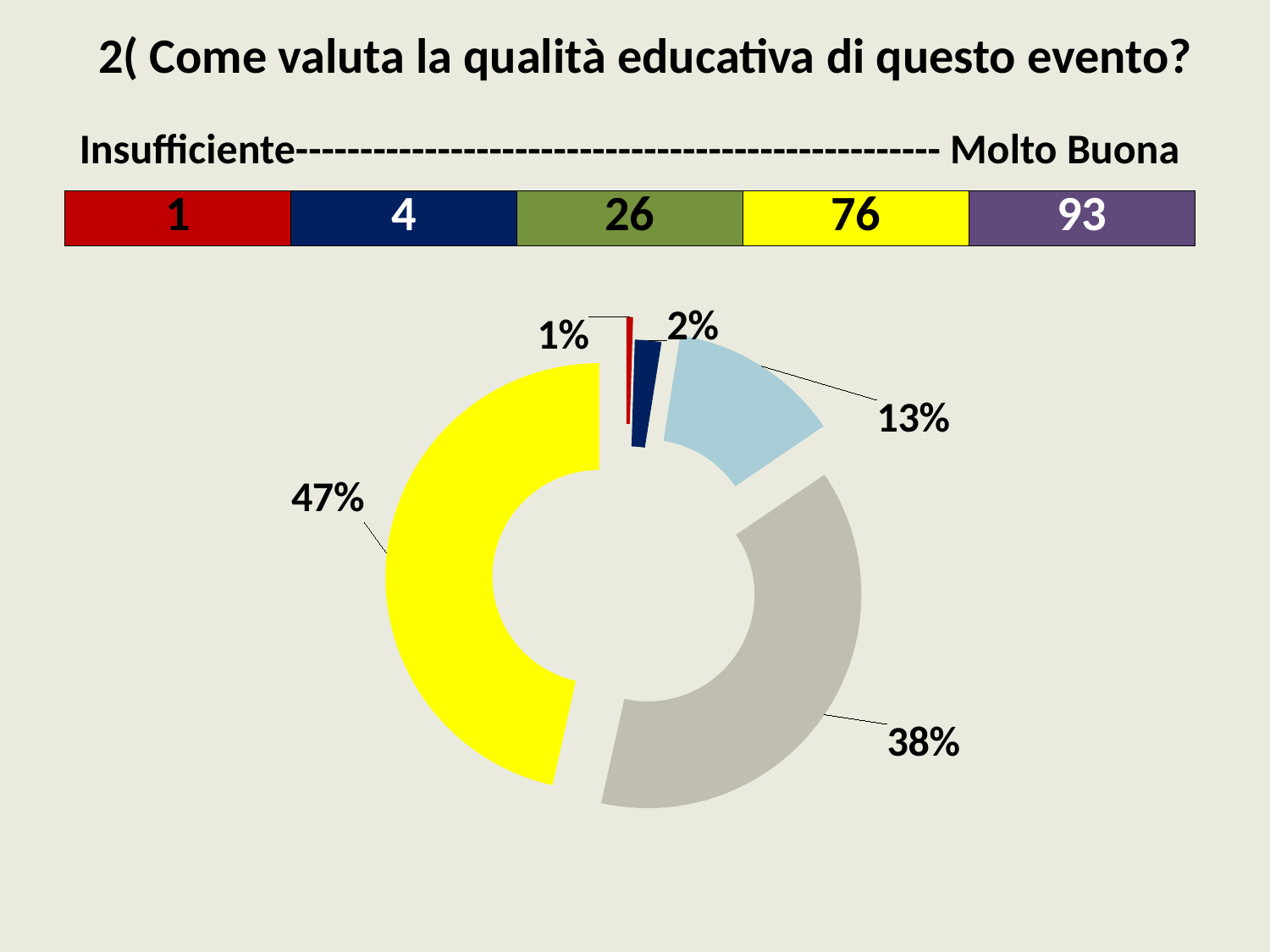
Is the value of the yellow slice greater or less than 40%? greater What is the largest percentage shown on the doughnut chart? 47% What percentage is labelled on the grey slice of the doughnut chart? 38% What is the smallest percentage shown on the doughnut chart? 1% What percentage is labelled on the light blue slice of the doughnut chart? 13% Which slice is larger, the light blue one or the grey one? the grey one (38%) What percentage is labelled on the yellow slice of the doughnut chart? 47% What question is written as the title at the top of the slide? 2( Come valuta la qualità educativa di questo evento? What kind of chart is shown on the slide? doughnut chart What colour is the largest slice of the doughnut chart? yellow How many slices does the doughnut chart have? 5 What is the difference in percentage points between the 47% slice and the 38% slice? 9